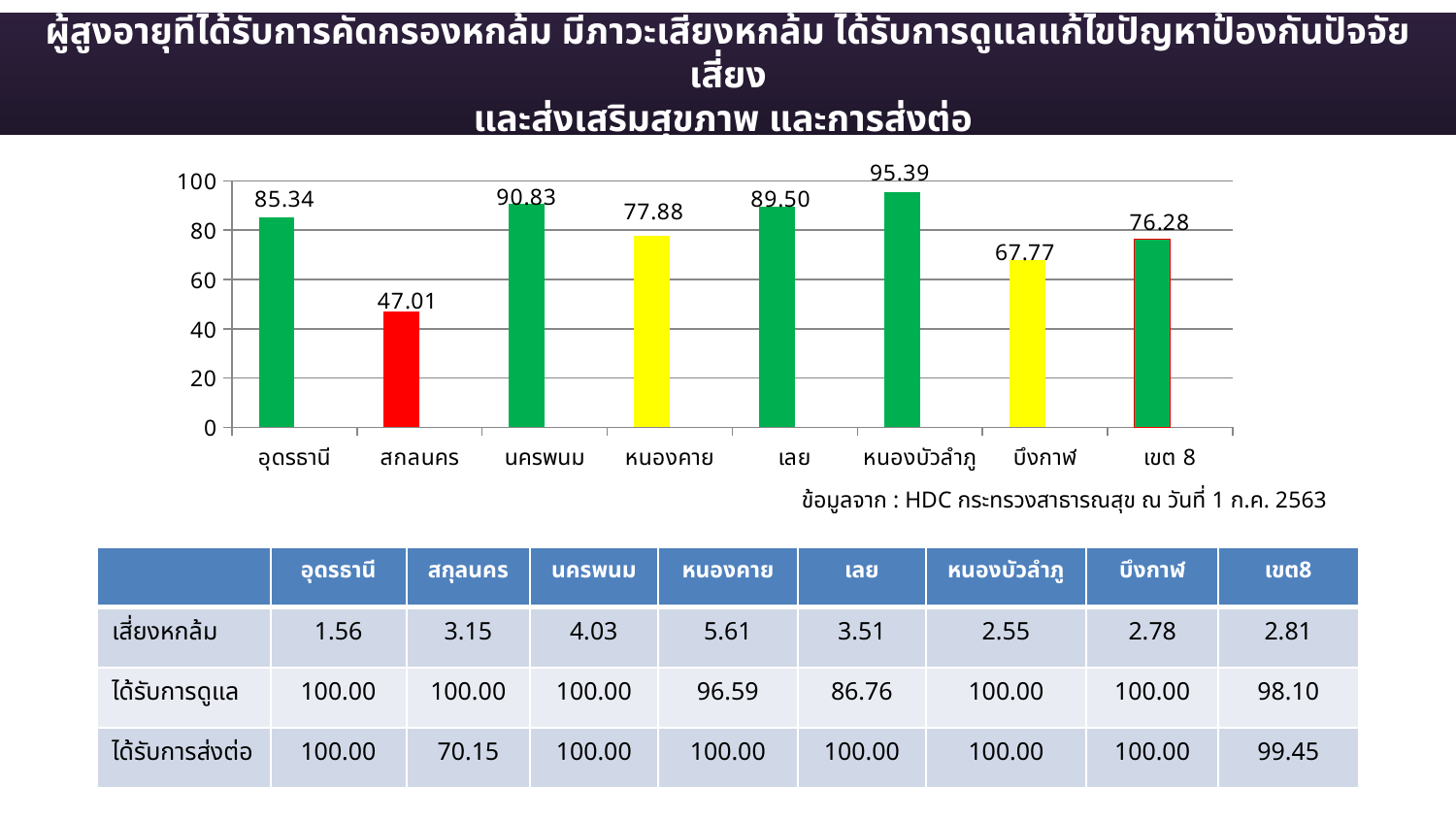
What colour is the bar for สกลนคร in the chart? red What is the value shown for อุดรธานี in the bar chart? 85.34 Which category has the highest value in the bar chart? หนองบัวลำภู What type of chart is shown on the slide? bar chart Which has a larger value in the bar chart, เลย or บึงกาฬ? เลย What is the value shown for เขต 8 in the bar chart? 76.28 Which category has the lowest value in the bar chart? สกลนคร What is the difference between the values for นครพนม and หนองคาย in the bar chart? 12.95 What is the value shown for หนองบัวลำภู in the bar chart? 95.39 Is the value for บึงกาฬ in the bar chart greater or less than 80? less How many categories are shown on the x axis of the bar chart? 8 What is the value shown for สกลนคร in the bar chart? 47.01